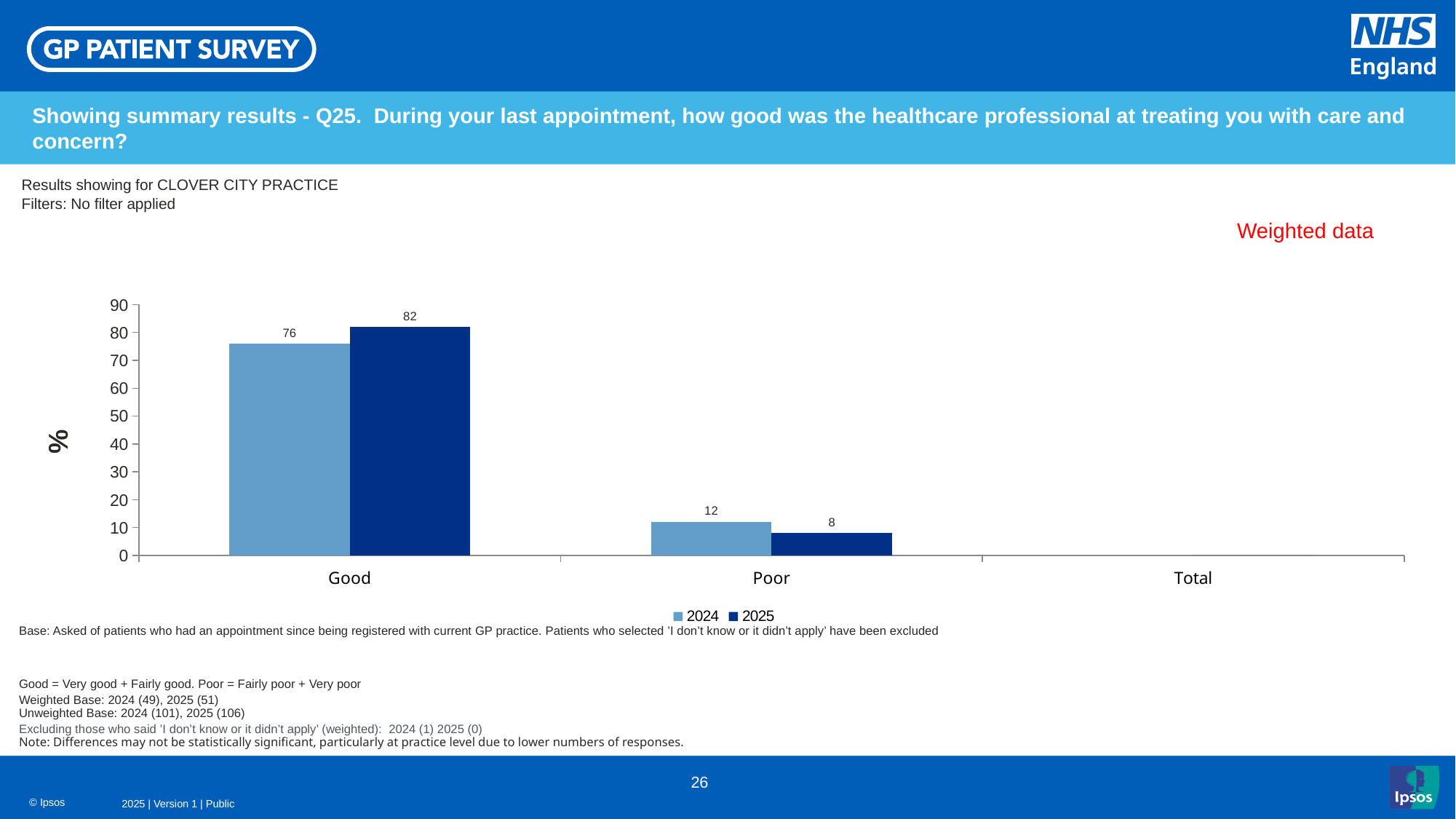
Which is larger, the 2024 value for Poor or the 2025 value for Poor? 2024 What is the difference between the 2025 and 2024 values for Good? 6 Which category has the lowest value in 2024? Poor What is the difference between the 2024 and 2025 values for Poor? 4 What is the value for Good in 2024? 76 What label is shown on the vertical axis? % What is the value for Poor in 2025? 8 How many series does the legend list? 2 What is the value for Poor in 2024? 12 What kind of chart is shown on the slide? Bar chart Which category has the highest value in 2025? Good What is the value for Good in 2025? 82